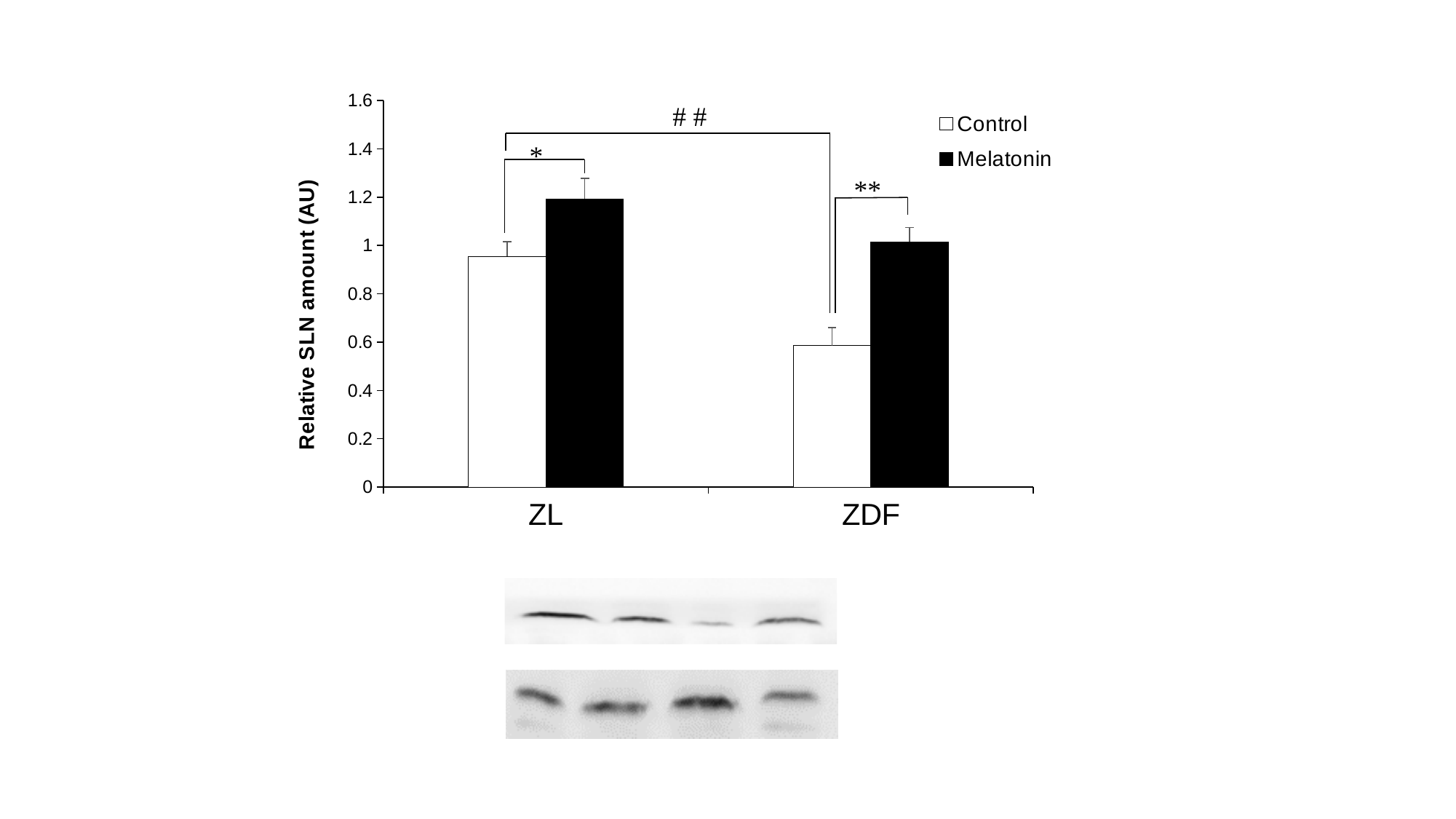
Which bar is the highest in the chart? Melatonin for ZL How many series does the legend list? 2 How many categories are shown on the x axis? 2 What kind of chart is shown on the slide? bar chart Which is larger, the Control value for ZL or the Control value for ZDF? Control for ZL Is the Melatonin value for ZDF greater or less than 0.8? greater Is the Control value for ZL greater or less than 0.8? greater Which bar is the lowest in the chart? Control for ZDF Is the Control value for ZDF greater or less than 0.8? less Which series is shown with black bars? Melatonin What is the title of the y axis? Relative SLN amount (AU)